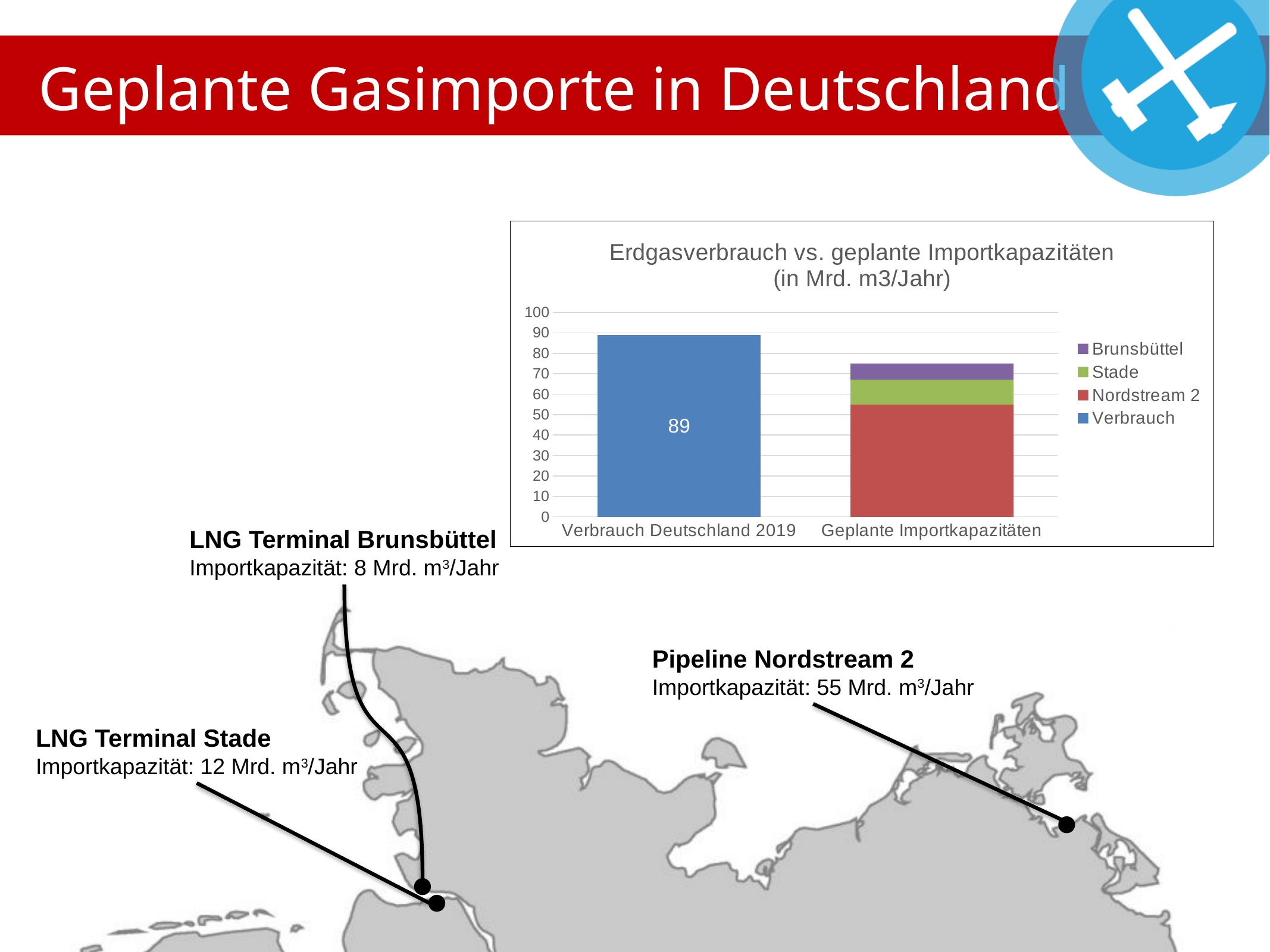
Is the total height of the Geplante Importkapazitäten bar greater or less than 70? greater What is the title of the chart? Erdgasverbrauch vs. geplante Importkapazitäten (in Mrd. m3/Jahr) Is the total height of the Geplante Importkapazitäten bar greater or less than 80? less Which category has the highest bar? Verbrauch Deutschland 2019 How many categories are shown on the x axis? 2 What is the value for Verbrauch Deutschland 2019? 89 Is the Nordstream 2 segment of the Geplante Importkapazitäten bar greater or less than 50? greater How many series does the legend list? 4 Which bar is taller: Verbrauch Deutschland 2019 or Geplante Importkapazitäten? Verbrauch Deutschland 2019 Which series forms the largest segment of the Geplante Importkapazitäten bar? Nordstream 2 Which series is shown in red in the legend? Nordstream 2 What kind of chart is shown on the slide? bar chart